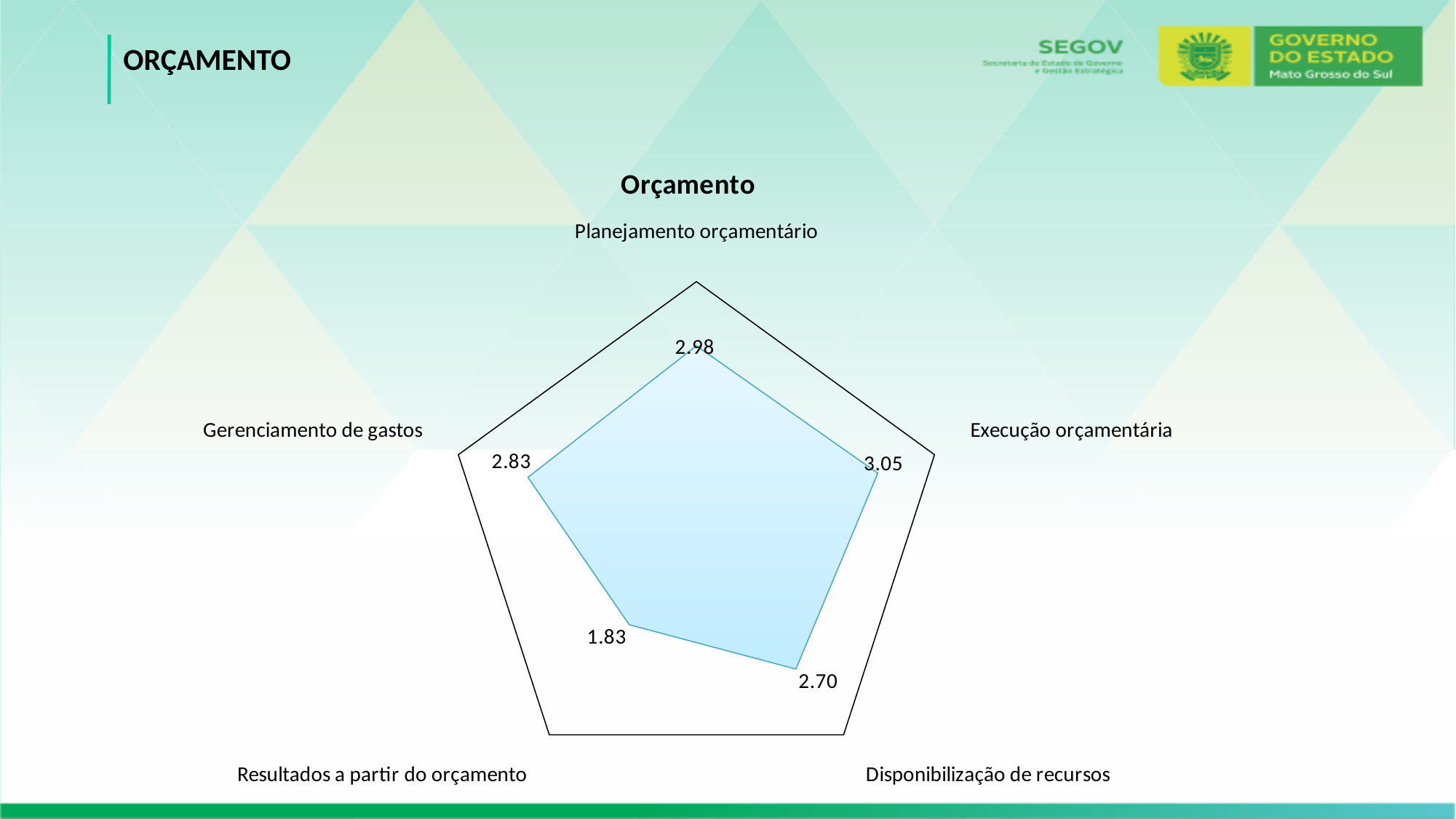
What is the value for Resultados a partir do orçamento? 1.83 What is the value for Planejamento orçamentário? 2.98 Which is larger, the value for Disponibilização de recursos or the value for Gerenciamento de gastos? Gerenciamento de gastos How many categories does the chart have? 5 What is the value for Disponibilização de recursos? 2.70 What kind of chart is shown on the slide? Radar chart What is the value for Gerenciamento de gastos? 2.83 What is the difference between the values for Planejamento orçamentário and Gerenciamento de gastos? 0.15 Which category has the highest value? Execução orçamentária What is the value for Execução orçamentária? 3.05 What is the difference between the values for Execução orçamentária and Resultados a partir do orçamento? 1.22 Which category has the lowest value? Resultados a partir do orçamento